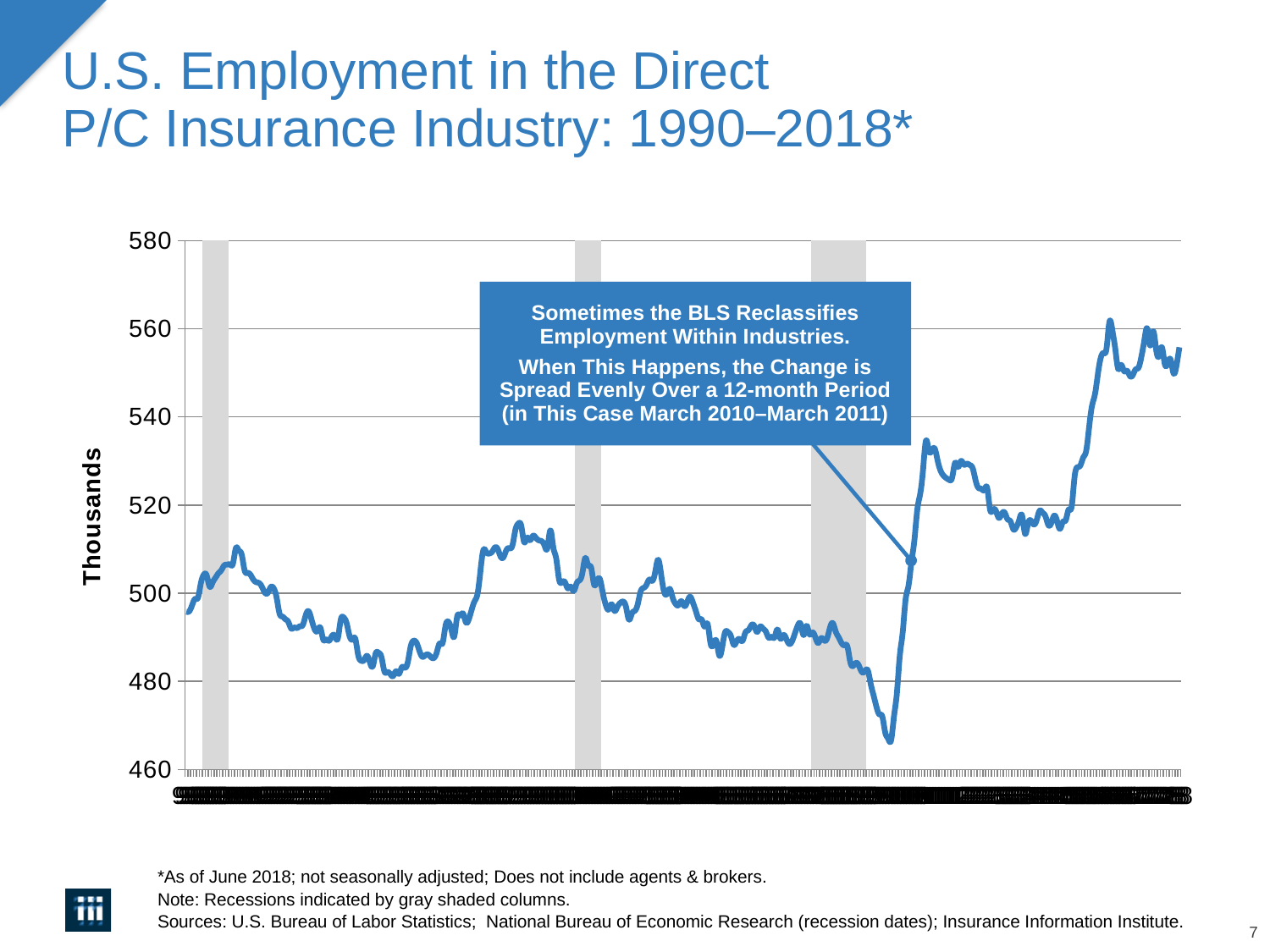
Comparing the left end of the line to the right end, does employment rise or fall over the period shown? rise Is the highest point of the line greater or less than 540? greater Is the value at the start of the line (left end) greater or less than 480? greater Is the value at the end of the line (right end) higher or lower than the value at the start of the line (left end)? higher What is the title of the chart on the slide? U.S. Employment in the Direct P/C Insurance Industry: 1990–2018* Is the lowest point of the line greater or less than 460? greater What is the label on the vertical axis of the chart? Thousands What kind of chart is shown on the slide? line chart How many gray shaded recession columns appear on the chart? 3